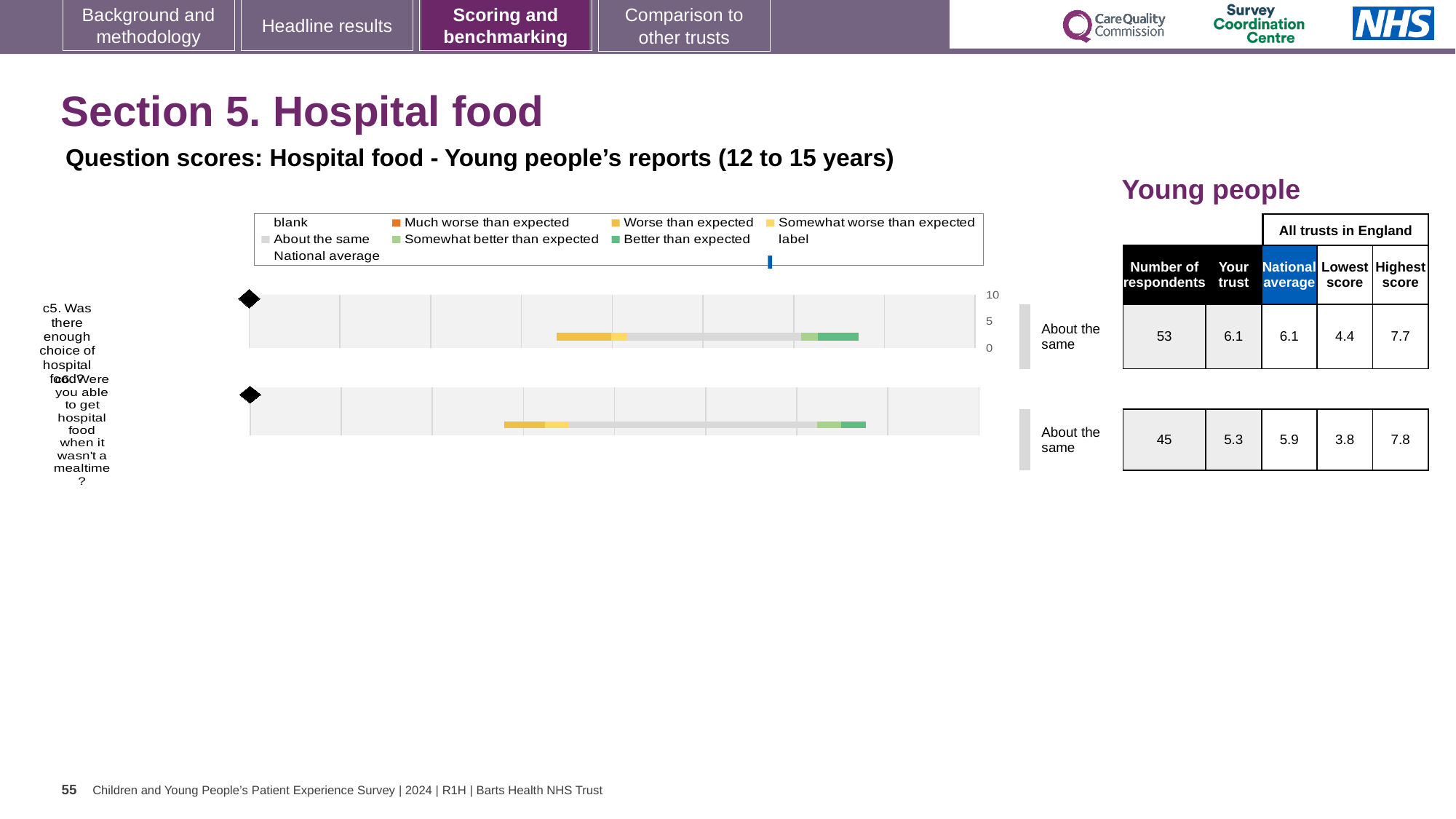
What is the national average score for question c6 (Were you able to get hospital food when it wasn't a mealtime?)? 5.9 Is the 'Your trust' score for question c6 greater or less than 5? greater What is the highest score among all trusts in England for question c6? 7.8 How many respondents answered question c5? 53 What kind of chart is used to show the question scores for hospital food? Bar chart What is the difference between the highest and lowest scores for question c5? 3.3 How many questions are plotted in the hospital food chart? 2 By how much does the national average exceed the 'Your trust' score for question c6? 0.6 Which question has the higher 'Your trust' score, c5 or c6? c5 What is the 'Your trust' score for question c5 (Was there enough choice of hospital food?)? 6.1 Which question has more respondents, c5 or c6? c5 What benchmark category is shown next to the chart for question c5? About the same